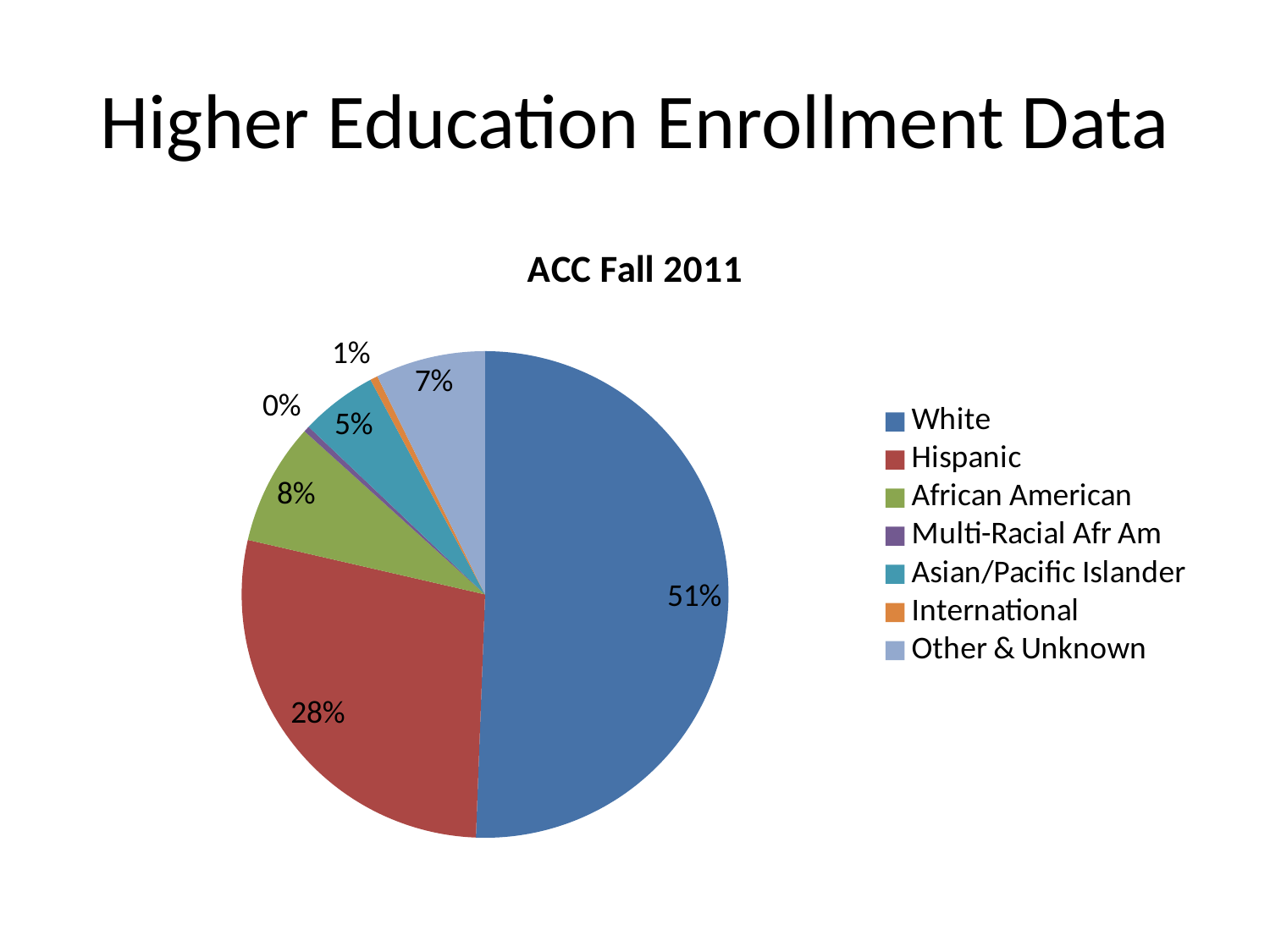
What is the chart's title? ACC Fall 2011 Which category has the largest share of the pie? White What share of the pie is Asian/Pacific Islander? 5% What share of the pie is White? 51% What share of the pie is International? 1% How many categories does the legend list? 7 What is the difference between the White share and the Hispanic share? 23% What type of chart is shown on the slide? pie chart Which category has the smallest share of the pie? Multi-Racial Afr Am